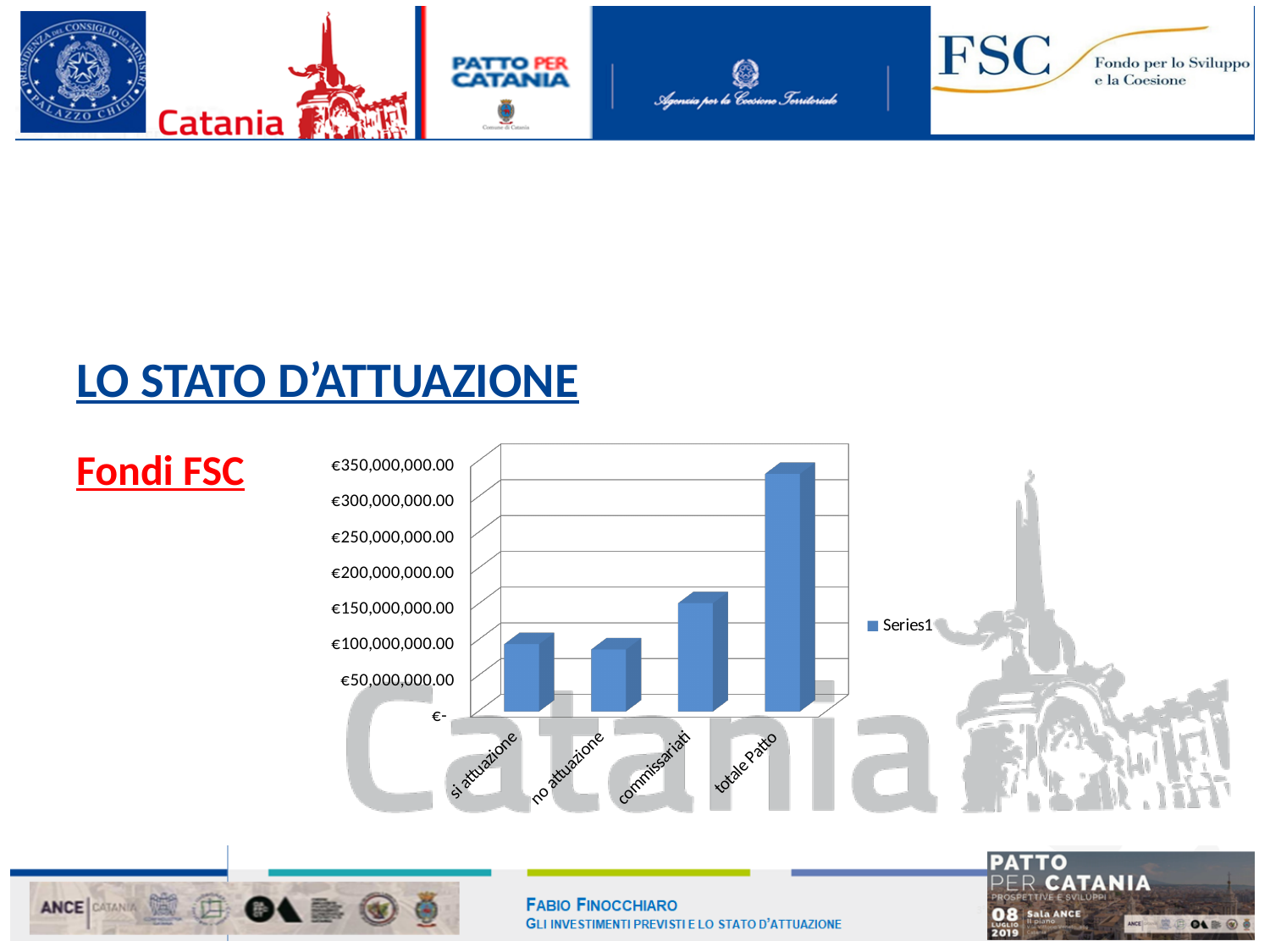
What kind of chart is shown on the slide? bar chart What is the highest value labelled on the vertical axis of the chart? €350,000,000.00 Is the value for no attuazione greater or less than €100,000,000.00? less How many series does the chart legend list? 1 Which is larger, the value for totale Patto or the value for commissariati? totale Patto Is the value for totale Patto greater or less than €300,000,000.00? greater How many categories are shown on the x axis of the chart? 4 What is the name of the series shown in the chart legend? Series1 Which category has the highest value in the chart? totale Patto Is the value for commissariati greater or less than €100,000,000.00? greater Which is larger, the value for commissariati or the value for si attuazione? commissariati